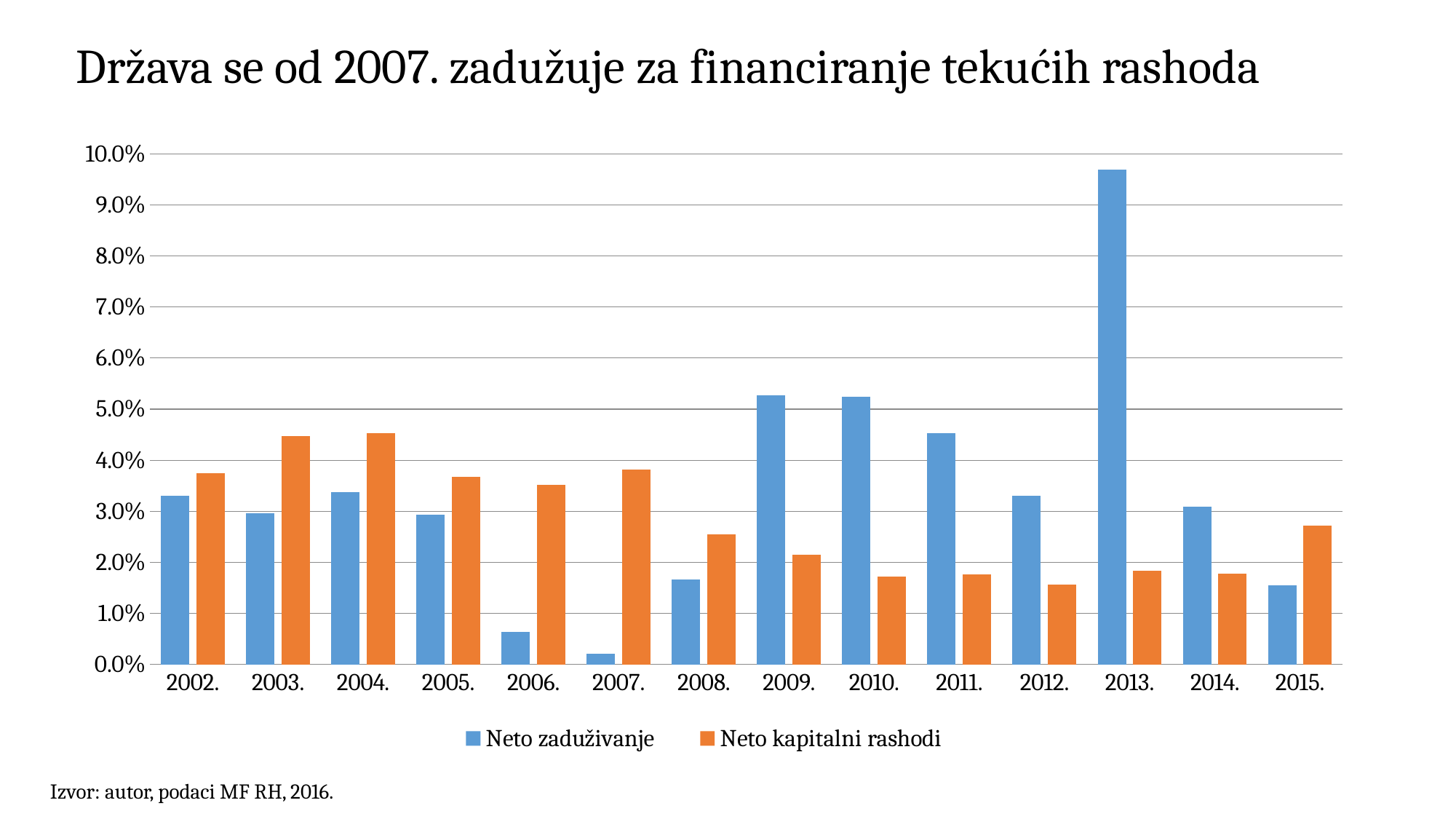
In 2007., which is larger: Neto zaduživanje or Neto kapitalni rashodi? Neto kapitalni rashodi In 2013., which is larger: Neto zaduživanje or Neto kapitalni rashodi? Neto zaduživanje Is the value of Neto zaduživanje for 2013. greater or less than 9.0%? greater What is the title of the chart? Država se od 2007. zadužuje za financiranje tekućih rashoda How many years are shown on the x axis? 14 How many series does the legend list? 2 In which year is Neto zaduživanje highest? 2013. Is the value of Neto zaduživanje for 2007. greater or less than 1.0%? less Is the value of Neto zaduživanje for 2009. greater or less than 5.0%? greater In which year is Neto zaduživanje lowest? 2007. What kind of chart is shown on the slide? bar chart